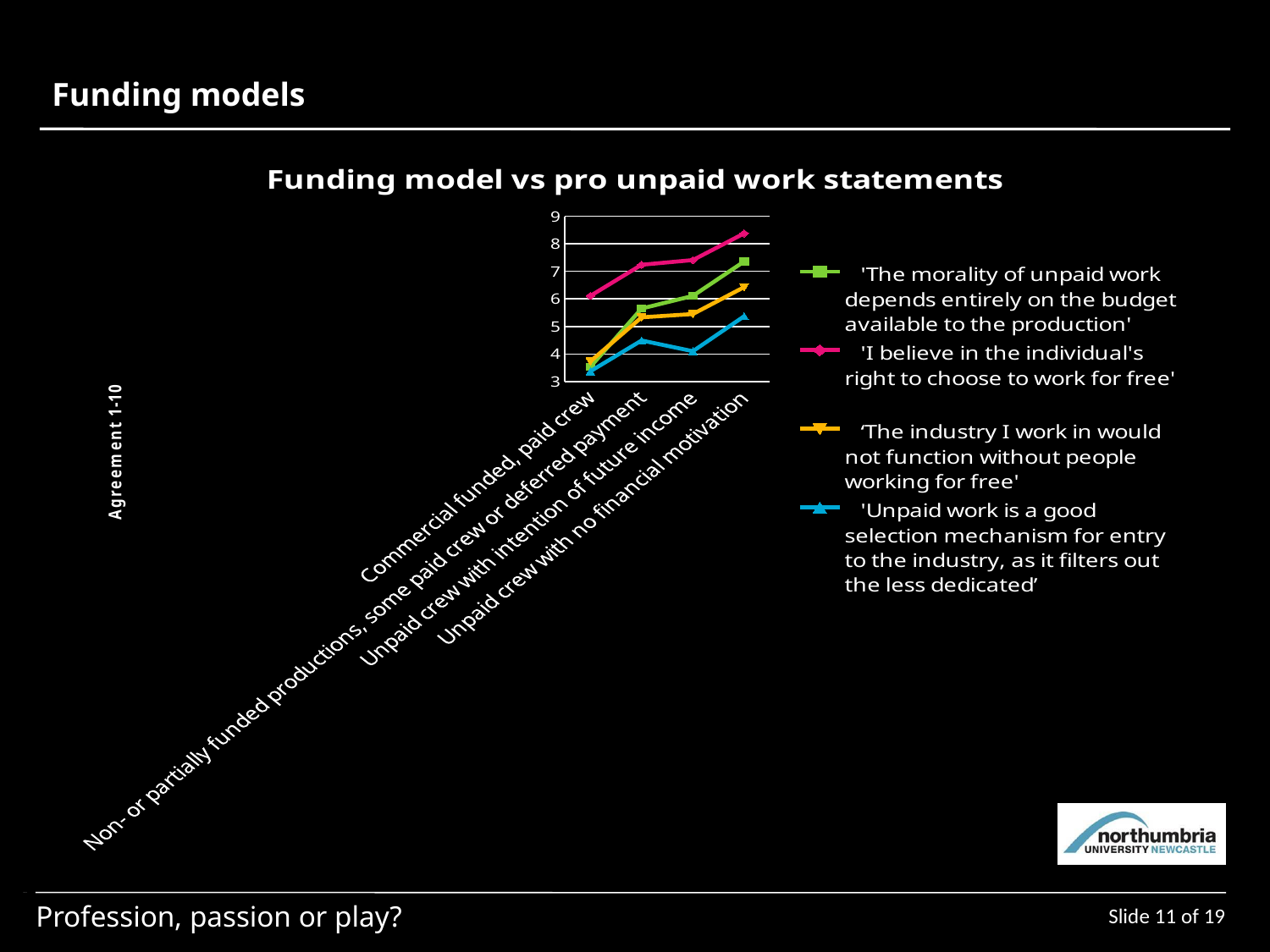
What is the title of the chart? Funding model vs pro unpaid work statements Is the value of 'The morality of unpaid work depends entirely on the budget available to the production' for 'Unpaid crew with no financial motivation' greater or less than 7? greater Does the series 'I believe in the individual's right to choose to work for free' rise or fall from left to right along the x axis? rise For 'Non- or partially funded productions, some paid crew or deferred payment', which is larger: the value for 'I believe in the individual's right to choose to work for free' or the value for 'The morality of unpaid work depends entirely on the budget available to the production'? 'I believe in the individual's right to choose to work for free' Which series is plotted in pink? 'I believe in the individual's right to choose to work for free' Is the value of 'Unpaid work is a good selection mechanism for entry to the industry, as it filters out the less dedicated' for 'Commercial funded, paid crew' greater or less than 5? less Which series has the lowest value for 'Unpaid crew with no financial motivation'? 'Unpaid work is a good selection mechanism for entry to the industry, as it filters out the less dedicated' How many series does the legend list? 4 What kind of chart is shown on the slide? line chart How many funding model categories are plotted along the x axis? 4 Is the value of 'I believe in the individual's right to choose to work for free' for 'Unpaid crew with no financial motivation' greater or less than 8? greater Which series has the highest value for 'Unpaid crew with no financial motivation'? 'I believe in the individual's right to choose to work for free'